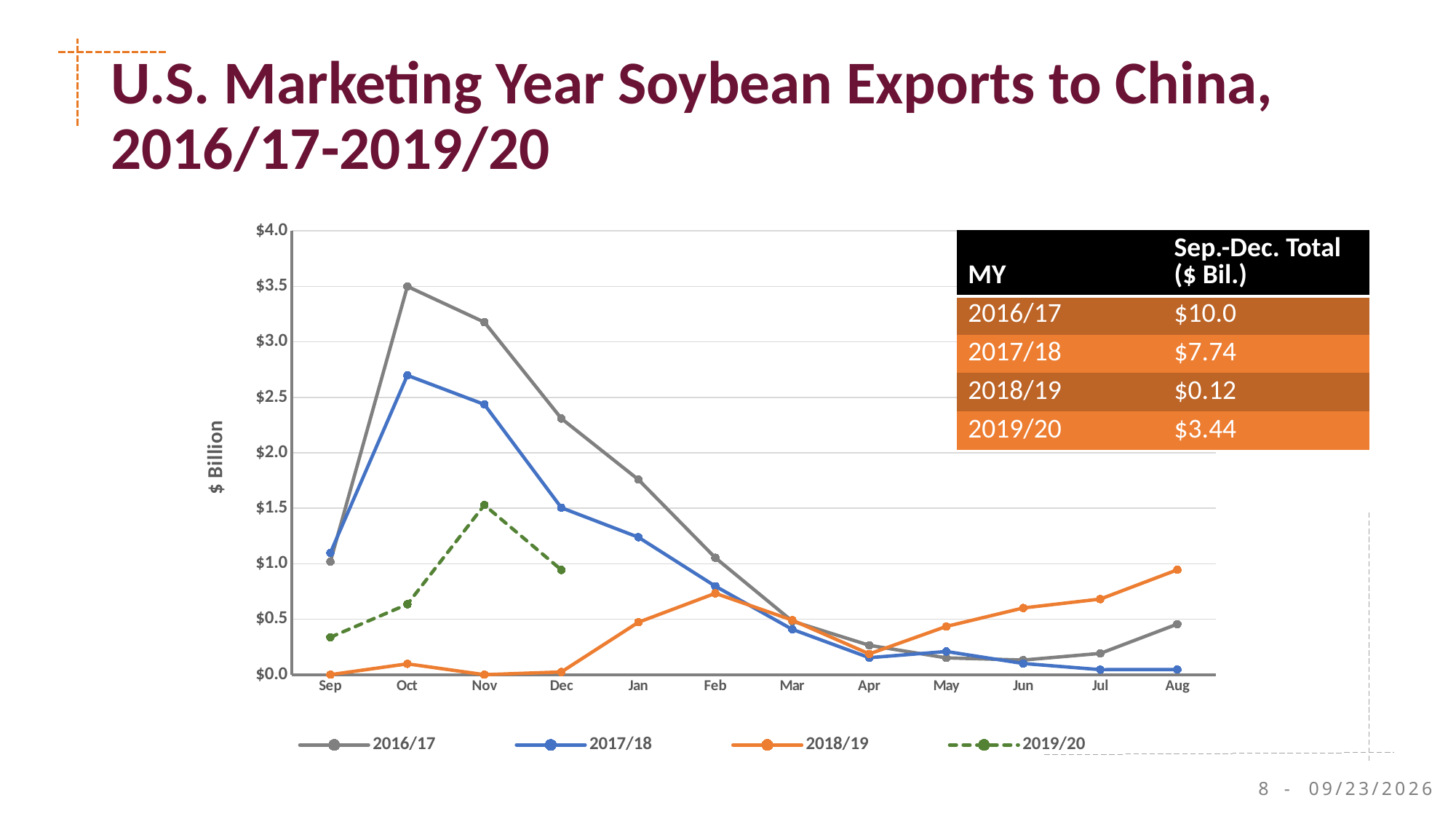
How many months are shown along the x axis? 12 Is the value for 2016/17 in Oct greater or less than $3.0? greater Is the value for 2017/18 in Oct greater or less than $2.5? greater Which series in the legend is drawn with a dashed line? 2019/20 Which marketing year has the highest value in Oct? 2016/17 Do the values for 2018/19 rise or fall from Mar to Aug? rise What kind of chart is shown on the slide? line chart How many series does the legend list? 4 Is the value for 2018/19 in Nov greater or less than $0.5? less Do the values for 2016/17 rise or fall from Oct to Apr? fall According to the table on the slide, what is the Sep.-Dec. total ($ Bil.) for 2018/19? $0.12 In Dec, which is larger: the value for 2017/18 or the value for 2019/20? 2017/18